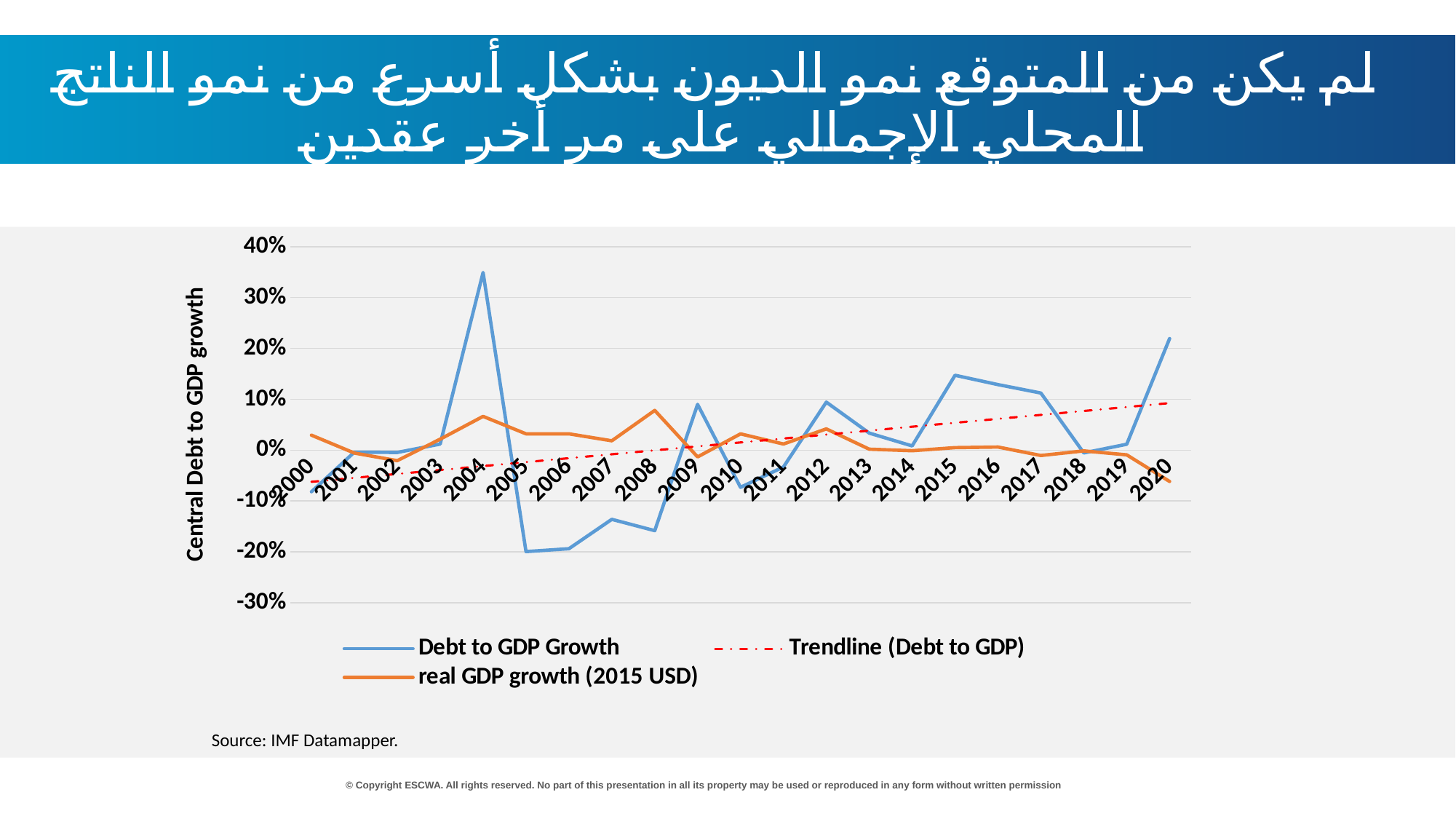
Does the Trendline (Debt to GDP) rise or fall from 2000 to 2020? rise In 2005, which is larger: Debt to GDP Growth or real GDP growth (2015 USD)? real GDP growth (2015 USD) Is the Debt to GDP Growth value for 2005 greater or less than -10%? less What is the title of the vertical axis? Central Debt to GDP growth Is the Debt to GDP Growth value for 2004 greater or less than 30%? greater In which year is Debt to GDP Growth highest? 2004 How many years are shown on the x axis? 21 What kind of chart is shown on the slide? line chart Is the Debt to GDP Growth value for 2015 greater or less than 10%? greater How many series does the legend list? 3 In which year is Debt to GDP Growth lowest? 2005